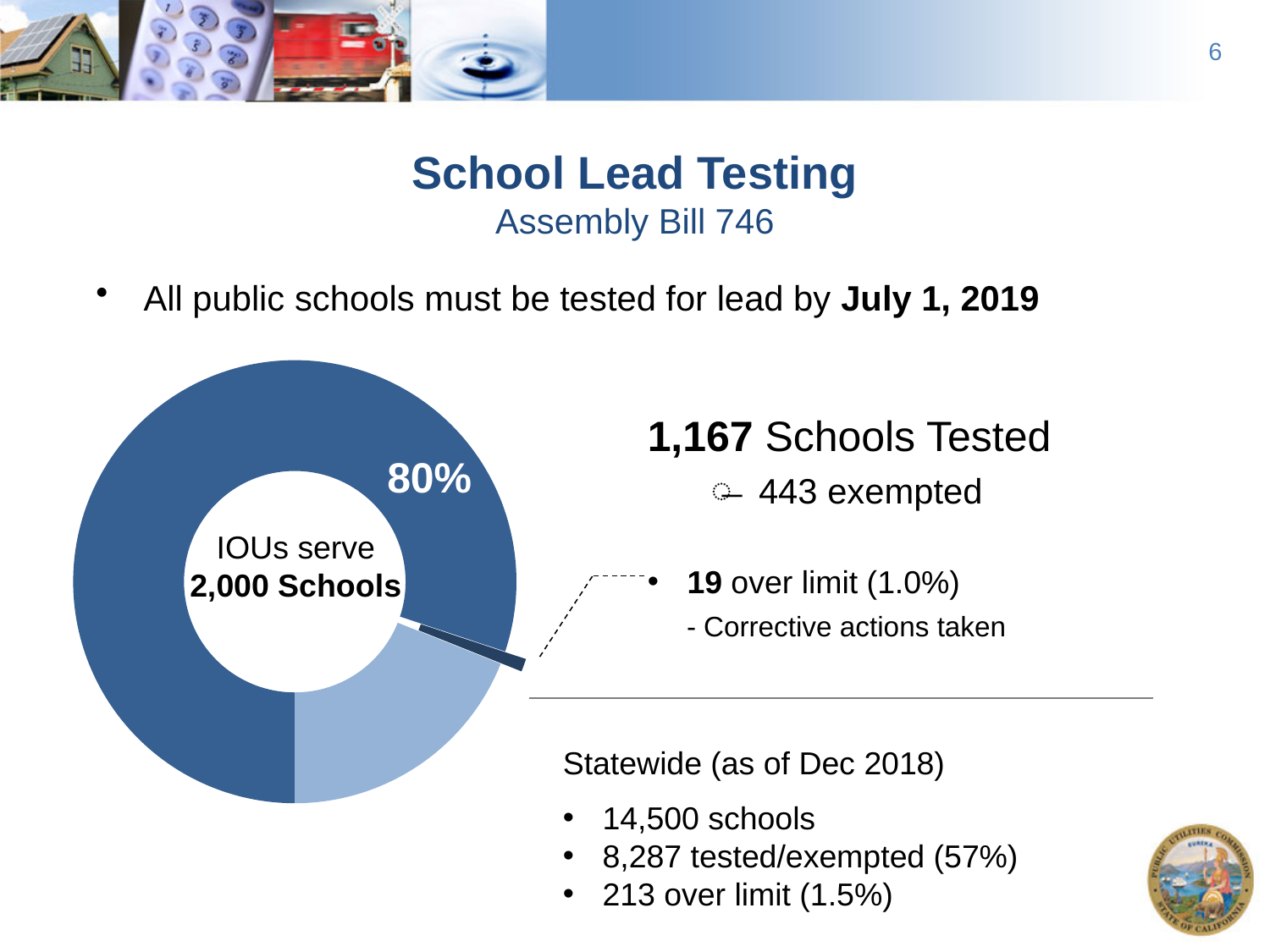
Which slice of the donut chart is the largest: the dark blue slice labelled 80% or the light blue slice? The dark blue slice labelled 80% What text appears in the centre of the donut chart? IOUs serve 2,000 Schools Is the share of the light blue slice in the donut chart greater or less than 50%? less What percentage is printed on the largest slice of the donut chart? 80% What colour is the largest slice of the donut chart? Dark blue Is the share of the dark blue slice in the donut chart greater or less than 50%? greater What share of the donut chart does the small slice connected to the '19 over limit' callout represent? 1.0% How many slices does the donut chart have? 3 How many schools do IOUs serve, according to the centre of the donut chart? 2,000 Schools Which slice of the donut chart is the smallest? The slice for 19 schools over limit (1.0%) How many schools does the small dark slice of the donut chart represent? 19 What kind of chart is shown on the slide? Pie chart (donut)